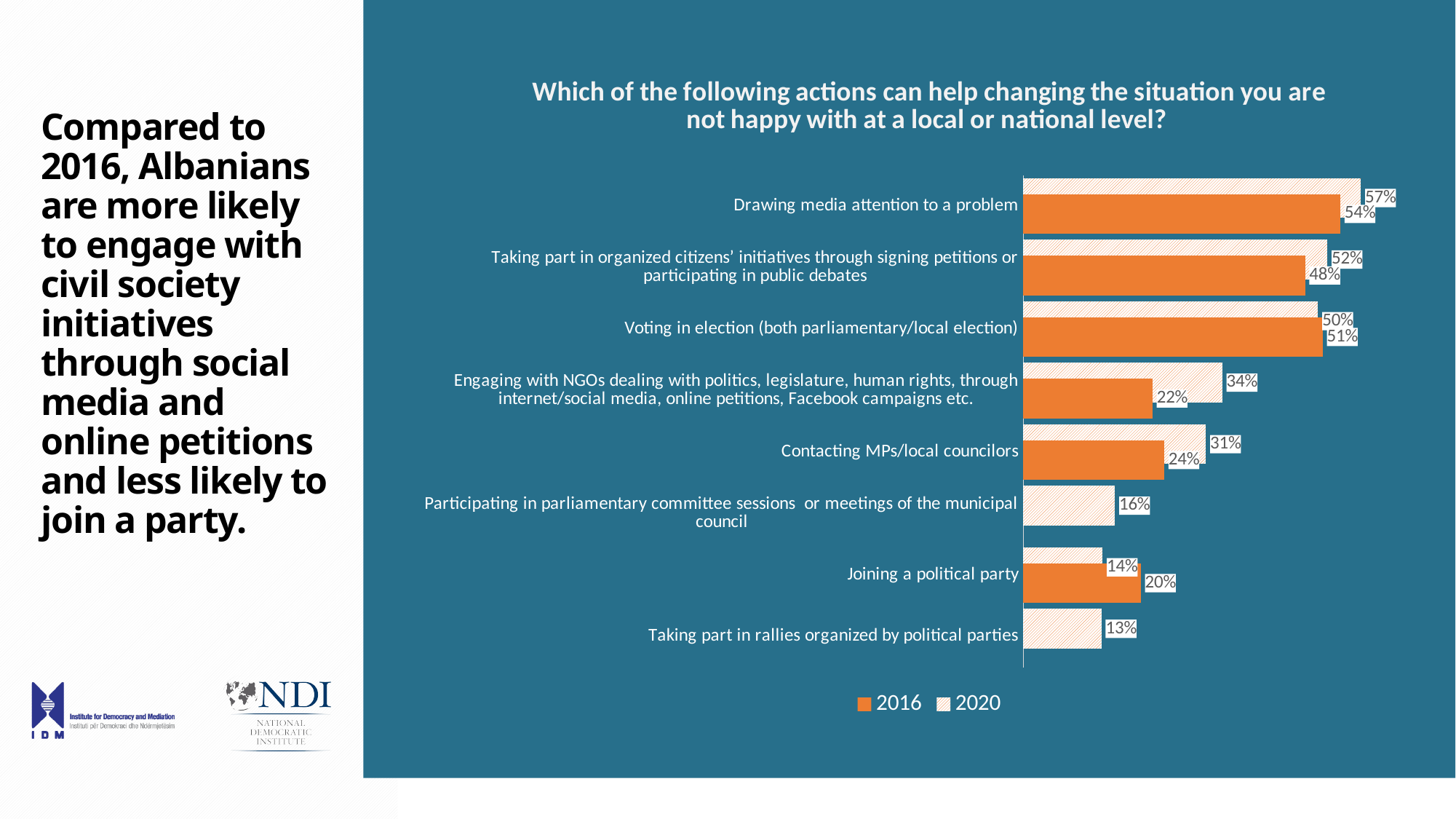
Which series is shown with solid orange bars in the legend? 2016 How many categories (actions) are shown in the chart? 8 Which action has the highest 2020 value? Drawing media attention to a problem What is the 2016 value for 'Joining a political party'? 20% For 'Joining a political party', which year has the larger value, 2016 or 2020? 2016 What is the 2020 value for 'Engaging with NGOs dealing with politics, legislature, human rights, through internet/social media, online petitions, Facebook campaigns etc.'? 34% What is the 2020 value for 'Drawing media attention to a problem'? 57% What is the difference between the 2020 and 2016 values for 'Engaging with NGOs dealing with politics, legislature, human rights, through internet/social media, online petitions, Facebook campaigns etc.'? 12% Which action has the lowest 2020 value? Taking part in rallies organized by political parties What is the 2016 value for 'Contacting MPs/local councilors'? 24% What type of chart is shown on the slide? bar chart How many series does the legend list? 2